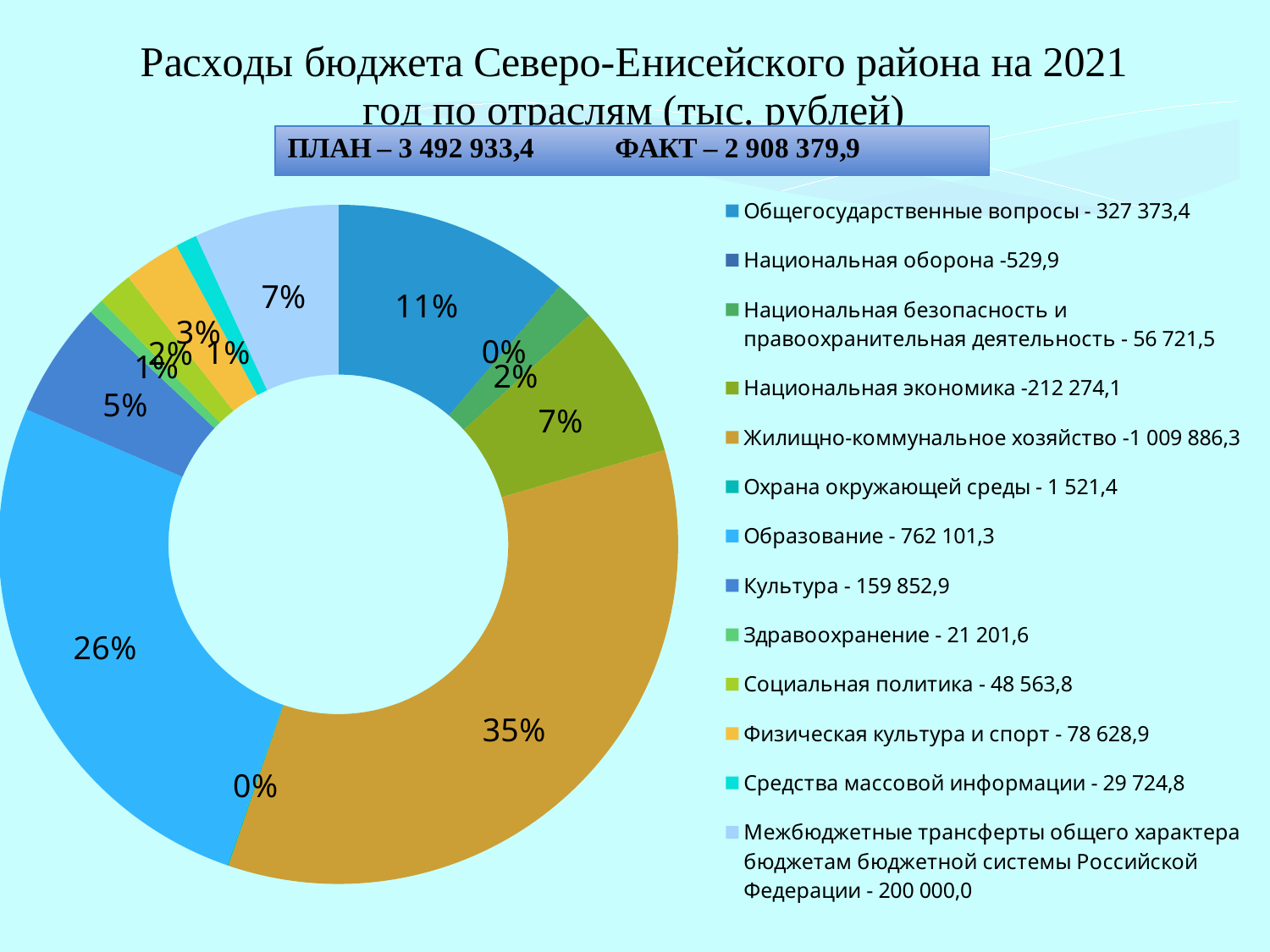
What is the ФАКТ (actual) total shown on the slide? 2 908 379,9 What kind of chart is shown on the slide? Doughnut (pie) chart What percentage is shown for Общегосударственные вопросы? 11% What value is shown in the legend for Образование? 762 101,3 Which category has the largest slice? Жилищно-коммунальное хозяйство What share of the chart does Образование take? 26% Which is larger, the slice for Образование or the slice for Национальная экономика? Образование What share of the chart does Жилищно-коммунальное хозяйство take? 35% How many categories does the legend list? 13 What value is shown in the legend for Национальная оборона? 529,9 What is the ПЛАН (planned) total shown on the slide? 3 492 933,4 What value is shown in the legend for Культура? 159 852,9